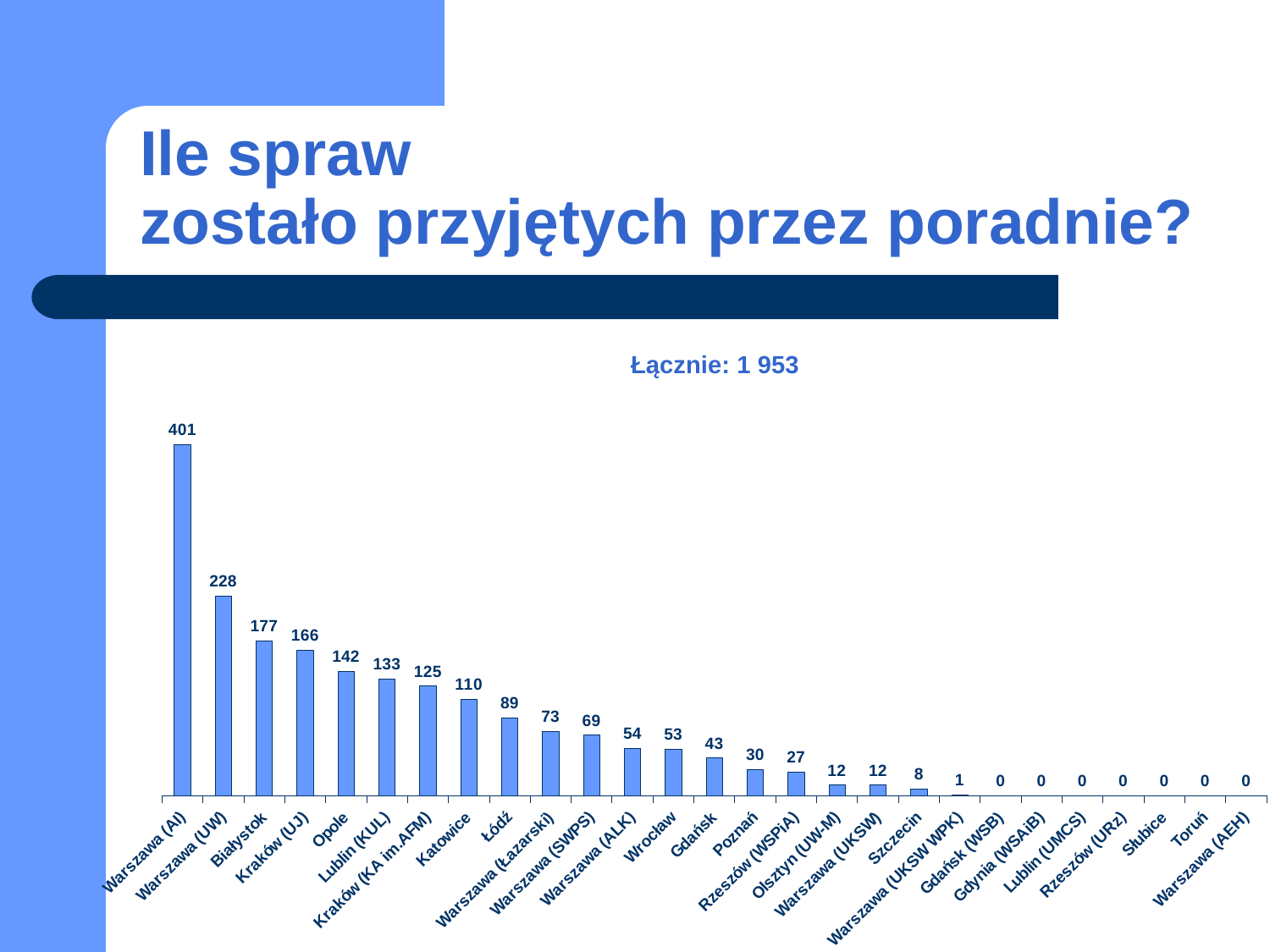
What total is stated in the chart title? 1 953 What is the difference between the values for Białystok and Opole? 35 How many categories are shown on the x axis? 27 Which is larger, the value for Gdańsk or the value for Poznań? Gdańsk What value is shown for Kraków (UJ)? 166 What value is shown for Rzeszów (WSPiA)? 27 What value is shown for Katowice? 110 What value is shown for Warszawa (AI)? 401 What kind of chart is shown on the slide? Bar chart Which category has the highest value? Warszawa (AI) What is the difference between the values for Warszawa (AI) and Warszawa (UW)? 173 Which is larger, the value for Lublin (KUL) or the value for Kraków (KA im.AFM)? Lublin (KUL)